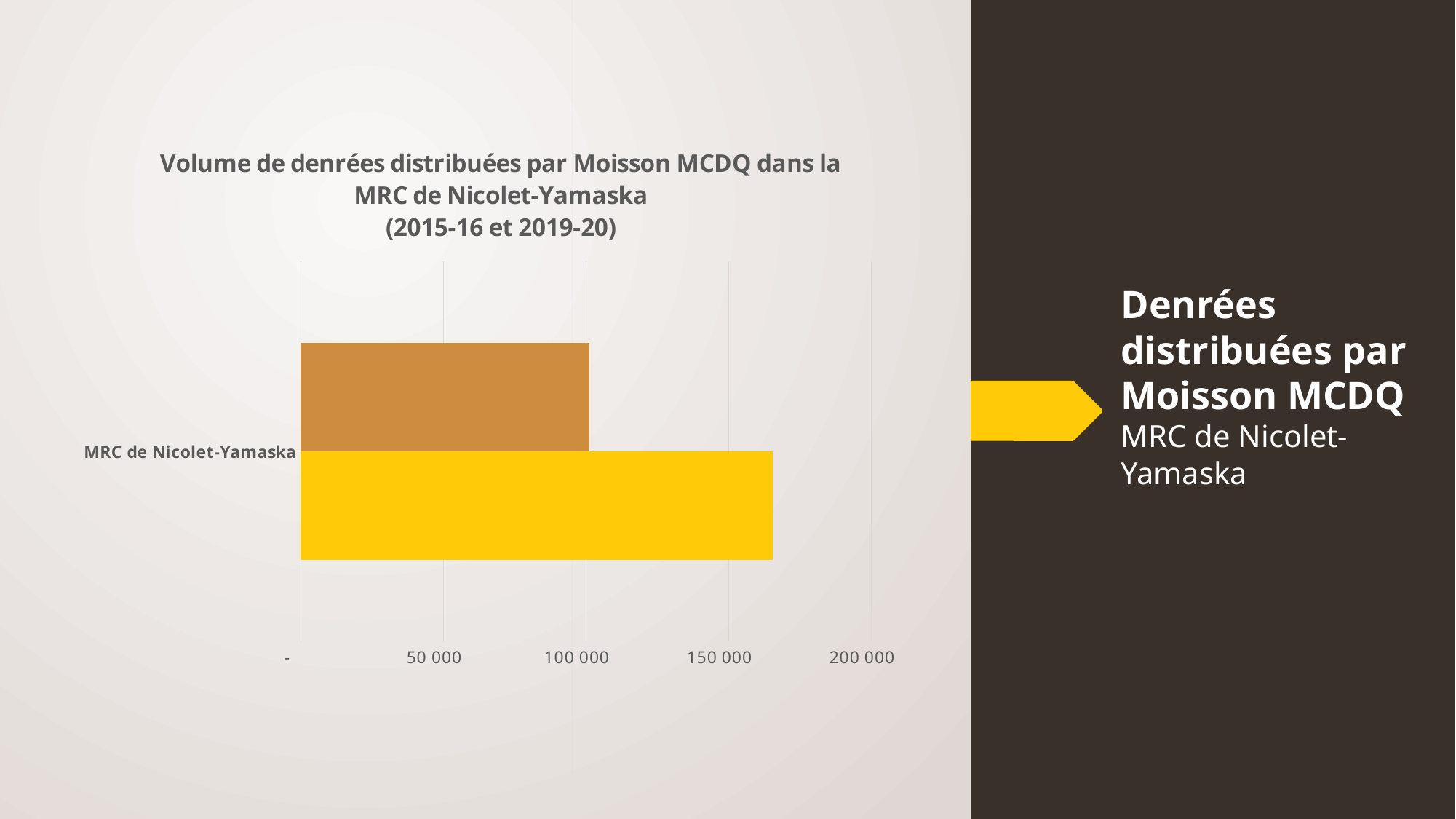
What is the highest value labelled on the horizontal axis? 200 000 How many bars are plotted for MRC de Nicolet-Yamaska? 2 How many categories are shown on the vertical axis of the chart? 1 Is the value of the brown bar greater or less than 50 000? greater What kind of chart is shown on the slide? bar chart What is the category label shown on the chart? MRC de Nicolet-Yamaska What is the title of the chart? Volume de denrées distribuées par Moisson MCDQ dans la MRC de Nicolet-Yamaska (2015-16 et 2019-20) Is the value of the yellow bar greater or less than 200 000? less Which bar is longer, the yellow bar or the brown bar? the yellow bar Is the value of the brown bar greater or less than 150 000? less